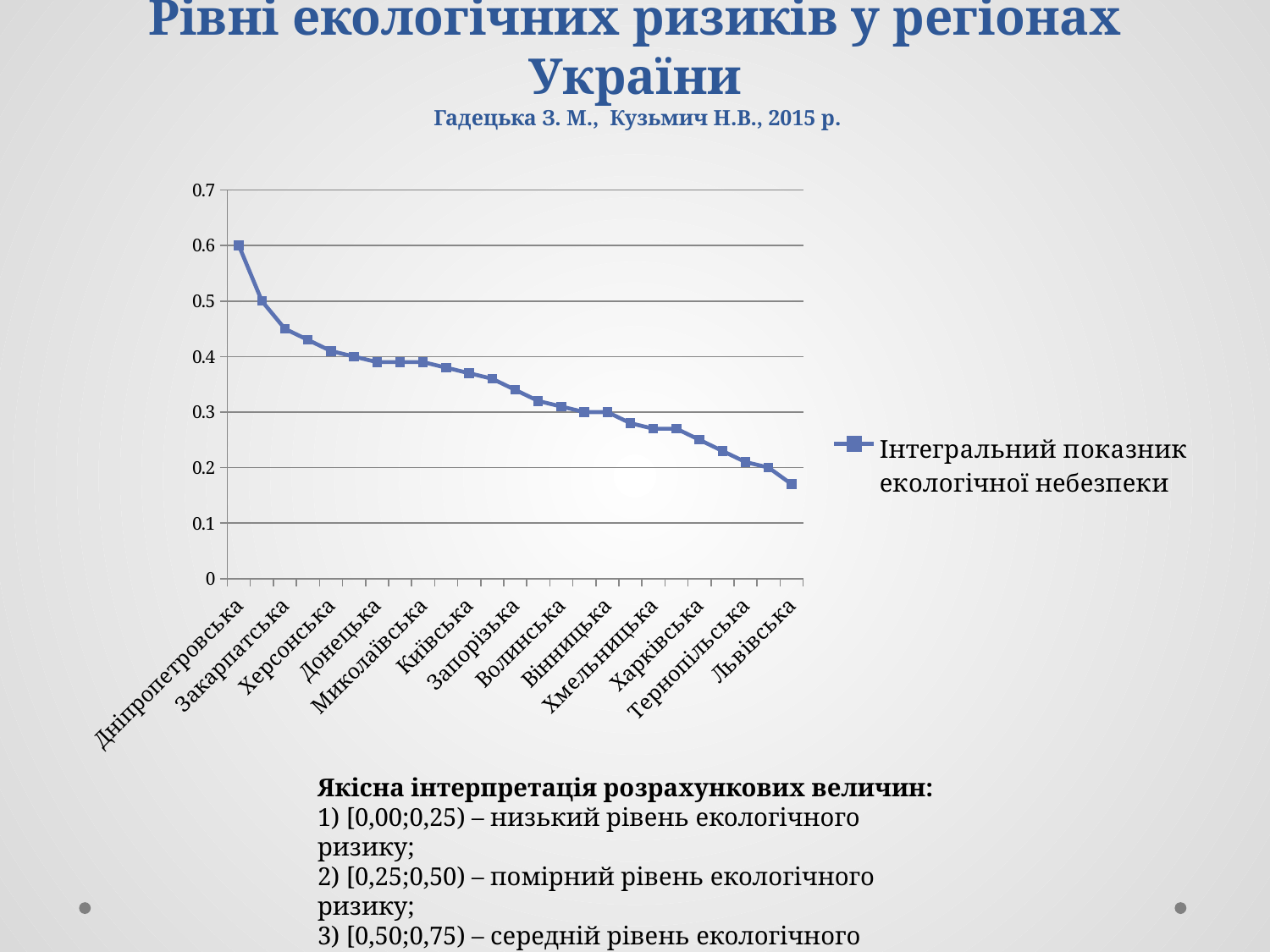
Which region has the lowest value of the integral indicator? Львівська What is the name of the series shown in the legend? Інтегральний показник екологічної небезпеки Which region has the highest value of the integral indicator? Дніпропетровська Which has a larger value, Закарпатська or Львівська? Закарпатська Is the value for Київська greater or less than 0.3? greater How many series does the legend list? 1 Is the value for Закарпатська greater or less than 0.4? greater Do the values rise or fall from left to right along the x axis? fall What type of chart is shown on the slide? line chart What is the value of the integral indicator for Дніпропетровська? 0.6 Is the value for Львівська greater or less than 0.2? less